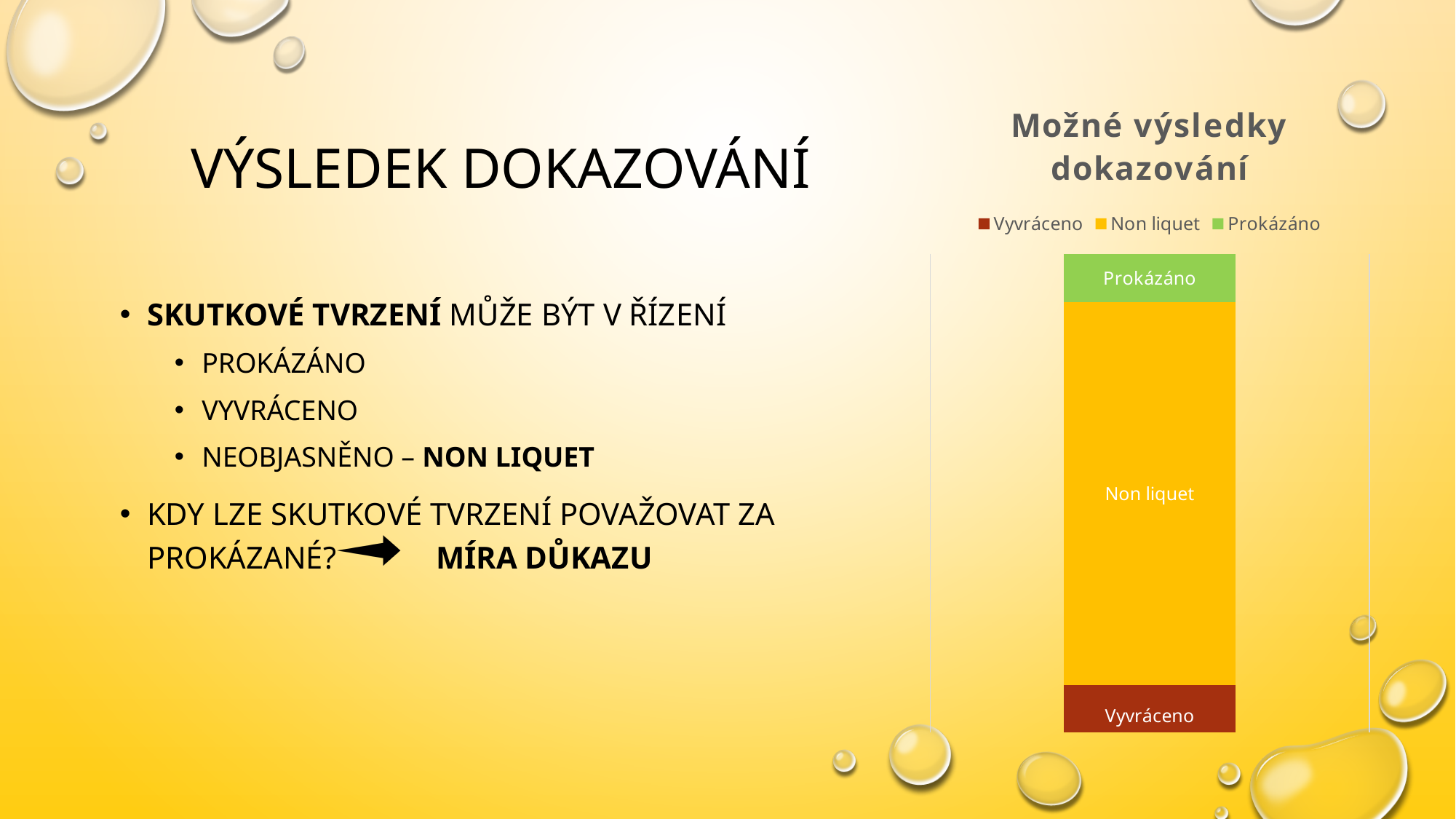
Which segment is at the bottom of the stacked bar? Vyvráceno Which is larger in the stacked bar, the Non liquet segment or the Vyvráceno segment? Non liquet Which segment of the stacked bar is the largest? Non liquet Which is larger in the stacked bar, the Prokázáno segment or the Non liquet segment? Non liquet What kind of chart is shown on the slide? Stacked bar chart How many bars are plotted in the chart? 1 Which series is shown in green in the chart? Prokázáno How many series does the chart's legend list? 3 What is the title of the chart on the slide? Možné výsledky dokazování